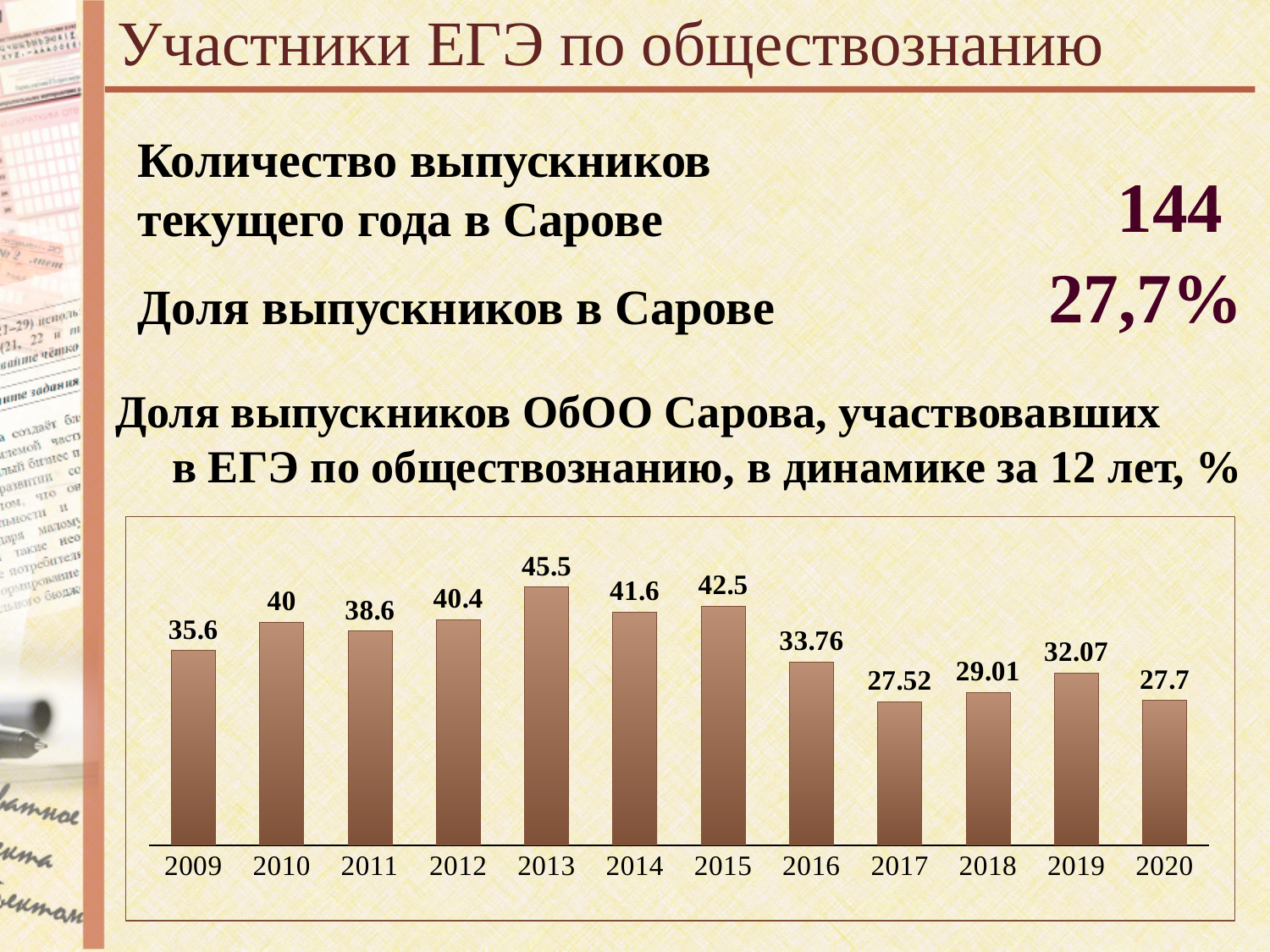
What is the value for 2013? 45.5 Which is larger, the value for 2012 or the value for 2019? 2012 What is the value for 2017? 27.52 What is the difference between the values for 2013 and 2020? 17.8 How many years are shown on the chart? 12 What is the first year shown on the x axis? 2009 Do the values rise or fall from 2016 to 2017? fall What kind of chart is shown on the slide? bar chart Which year has the lowest value? 2017 What is the value for 2020? 27.7 What is the difference between the values for 2015 and 2016? 8.74 Which year has the highest value? 2013